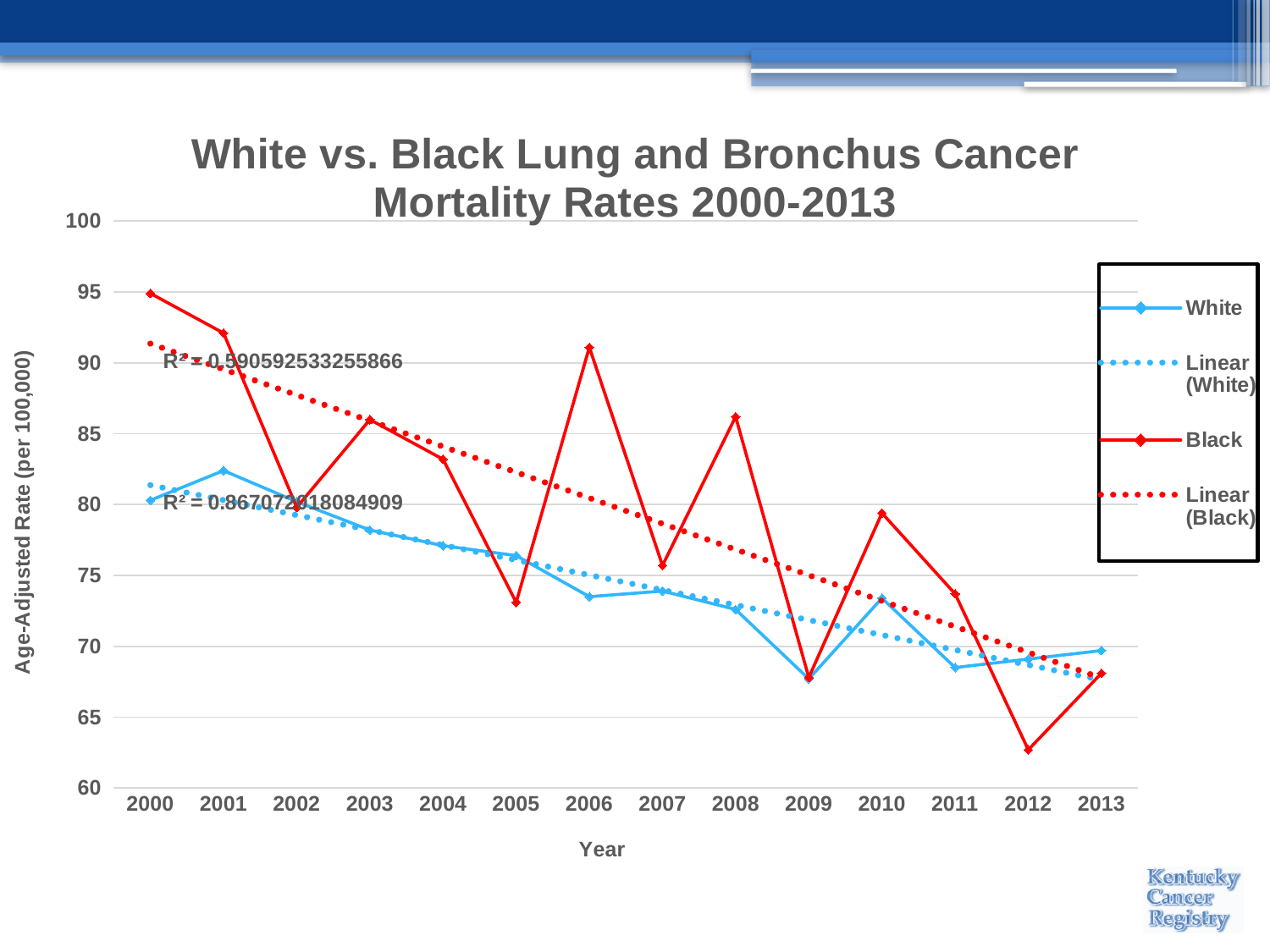
What is the label on the y axis of the chart? Age-Adjusted Rate (per 100,000) How many years are plotted along the x axis? 14 Which year has the highest value for the Black series? 2000 Which year has the lowest value for the Black series? 2012 Is the value for White in 2009 greater or less than 70? less Is the value for Black in 2000 greater or less than 90? greater In 2006, which series has the larger value, White or Black? Black Which year has the highest value for the White series? 2001 How many entries does the chart's legend list? 4 Overall, do the White series values rise or fall from 2000 to 2013? Fall What kind of chart is shown on the slide? Line chart Is the value for Black in 2012 greater or less than 65? less